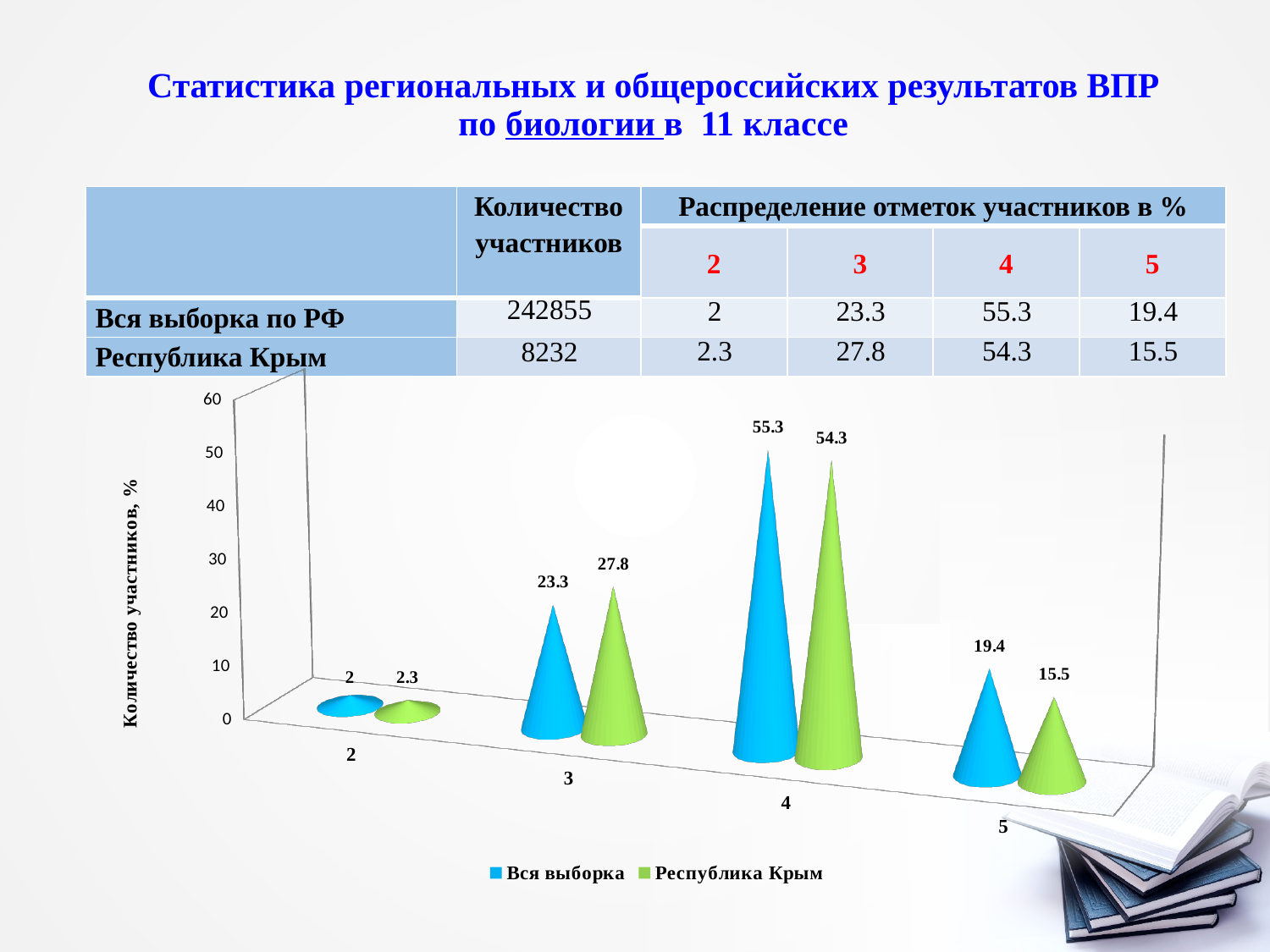
What is the value for "Республика Крым" at grade 5? 15.5 What kind of chart is shown on the slide? bar chart What is the value for "Республика Крым" at grade 3? 27.8 How many series does the chart legend list? 2 What is the label of the vertical axis of the chart? Количество участников, % What is the value for "Вся выборка" at grade 2? 2 What is the difference between "Вся выборка" and "Республика Крым" at grade 5? 3.9 What is the value for "Вся выборка" at grade 4? 55.3 Which grade has the highest value for "Республика Крым"? 4 Which grade has the lowest value for "Вся выборка"? 2 How many grade categories are shown on the x axis of the chart? 4 At grade 3, which series has the larger value, "Вся выборка" or "Республика Крым"? Республика Крым